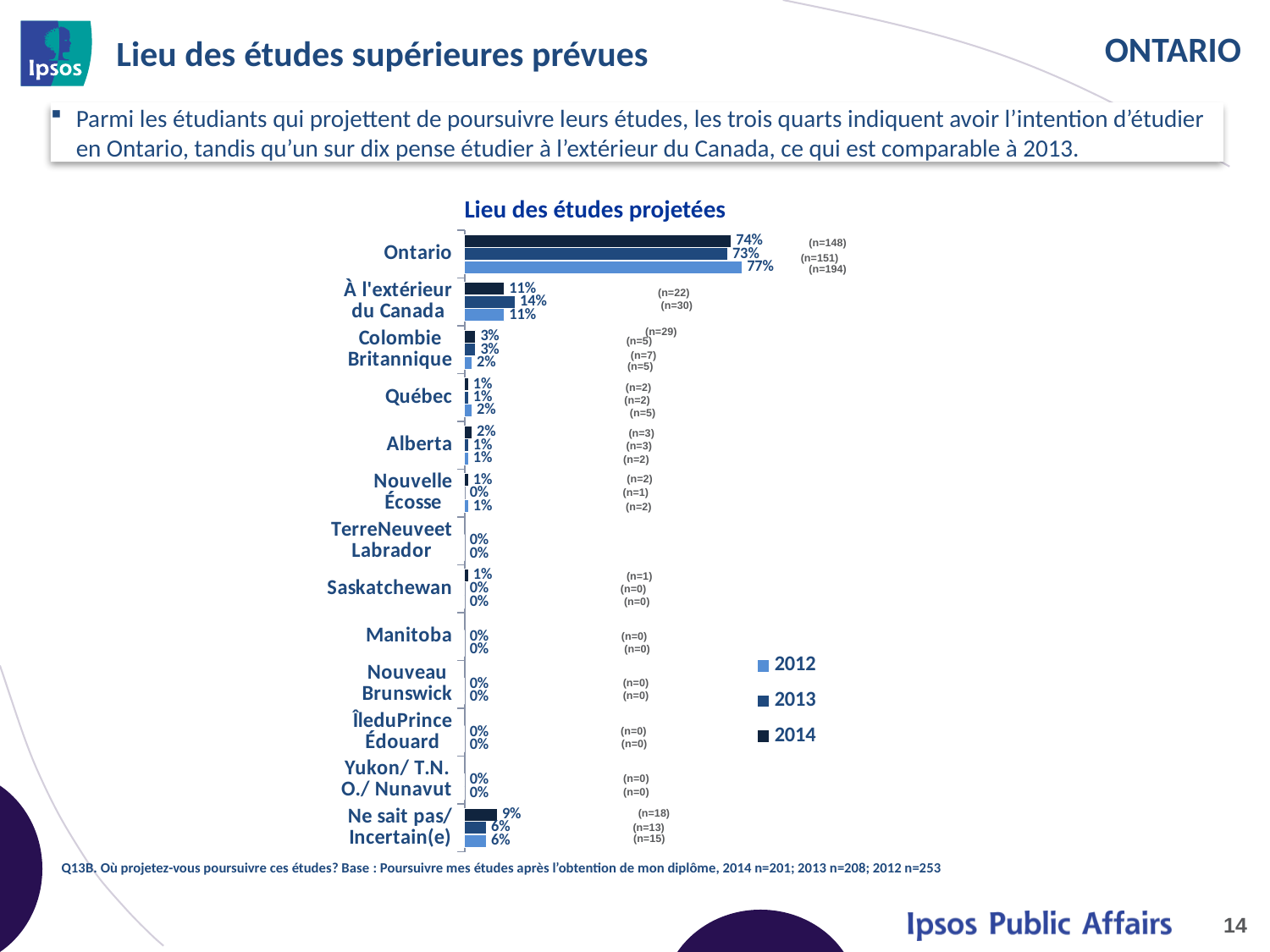
What type of chart is shown on the slide? bar chart How many categories are shown on the chart? 13 What is the value for À l'extérieur du Canada in 2013? 14% How many series does the legend list? 3 What is the value for Ontario in 2014? 74% What is the value for Ne sait pas/ Incertain(e) in 2014? 9% Which is larger for À l'extérieur du Canada: the 2013 value or the 2014 value? 2013 What is the title of the chart? Lieu des études projetées What is the value for Colombie Britannique in 2012? 2% Which category has the highest value in 2014? Ontario What is the value for Ontario in 2012? 77% What is the difference between the 2012 and 2014 values for Ontario? 3%